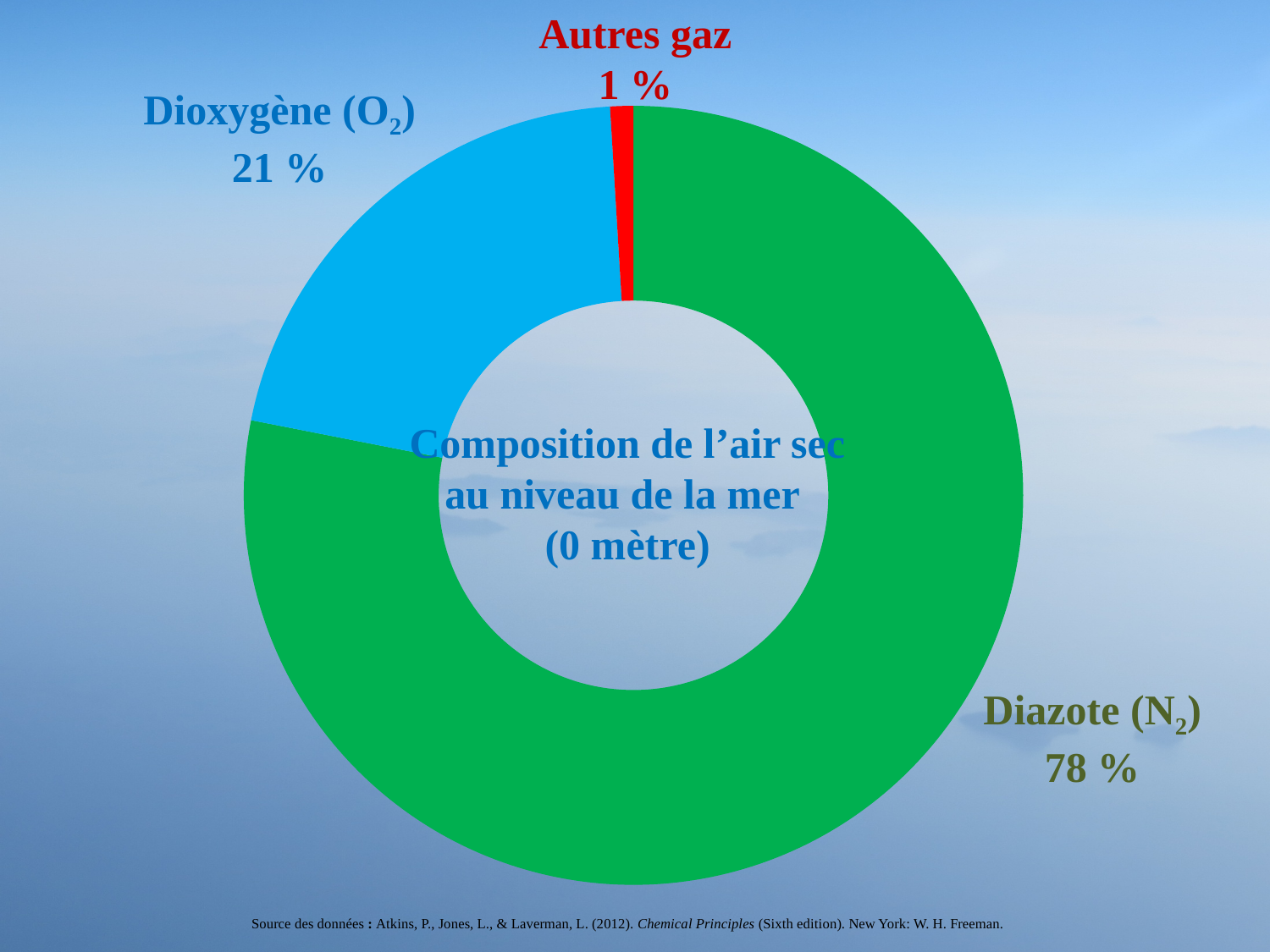
Which is larger, the share of Dioxygène (O2) or the share of Autres gaz? Dioxygène (O2) What is the title shown in the centre of the chart? Composition de l'air sec au niveau de la mer (0 mètre) What share of dry air at sea level is Diazote (N2)? 78 % How many categories are shown in the chart? 3 What share of dry air at sea level is Dioxygène (O2)? 21 % What kind of chart is shown on the slide? Doughnut (pie) chart Which gas has the largest share in the chart? Diazote (N2) What is the difference between the shares of Diazote (N2) and Dioxygène (O2)? 57 % What colour is the Dioxygène (O2) slice? Blue What is the difference between the shares of Dioxygène (O2) and Autres gaz? 20 % Which category has the smallest share in the chart? Autres gaz What share of dry air at sea level is Autres gaz? 1 %